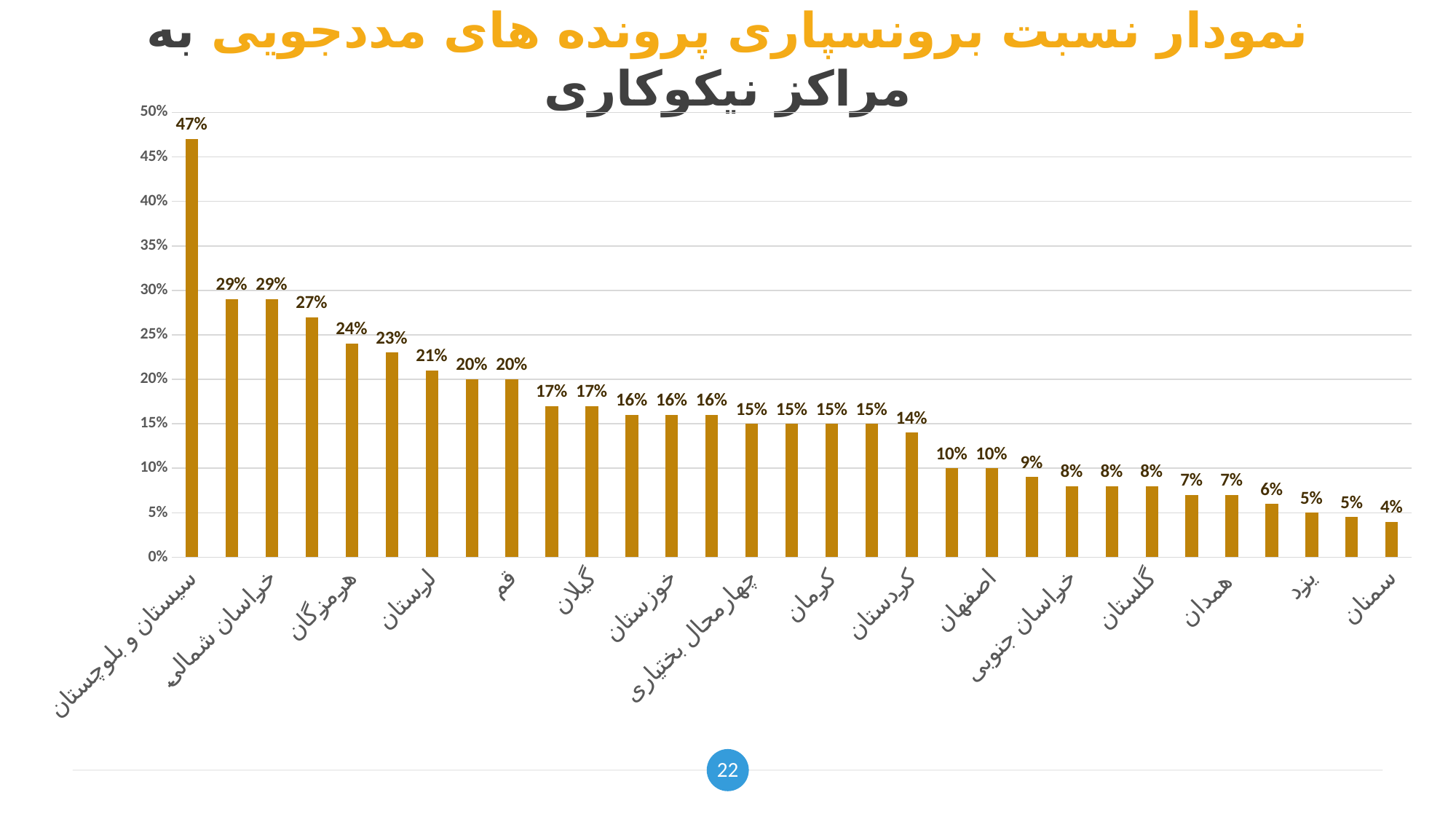
Which labelled province has the lowest value? سمنان What is the value for سیستان و بلوچستان? 47% What is the value for سمنان? 4% Do the values rise or fall from left to right along the x axis? fall What is the difference between the values for سیستان و بلوچستان and سمنان? 43 percentage points How many bars are plotted in the chart? 31 What is the value for هرمزگان? 24% Is the value for قم greater or less than 15%? greater Which is larger, the value for هرمزگان or the value for لرستان? هرمزگان What is the value for کردستان? 14% What kind of chart is shown on the slide? bar chart Which labelled province has the highest value? سیستان و بلوچستان